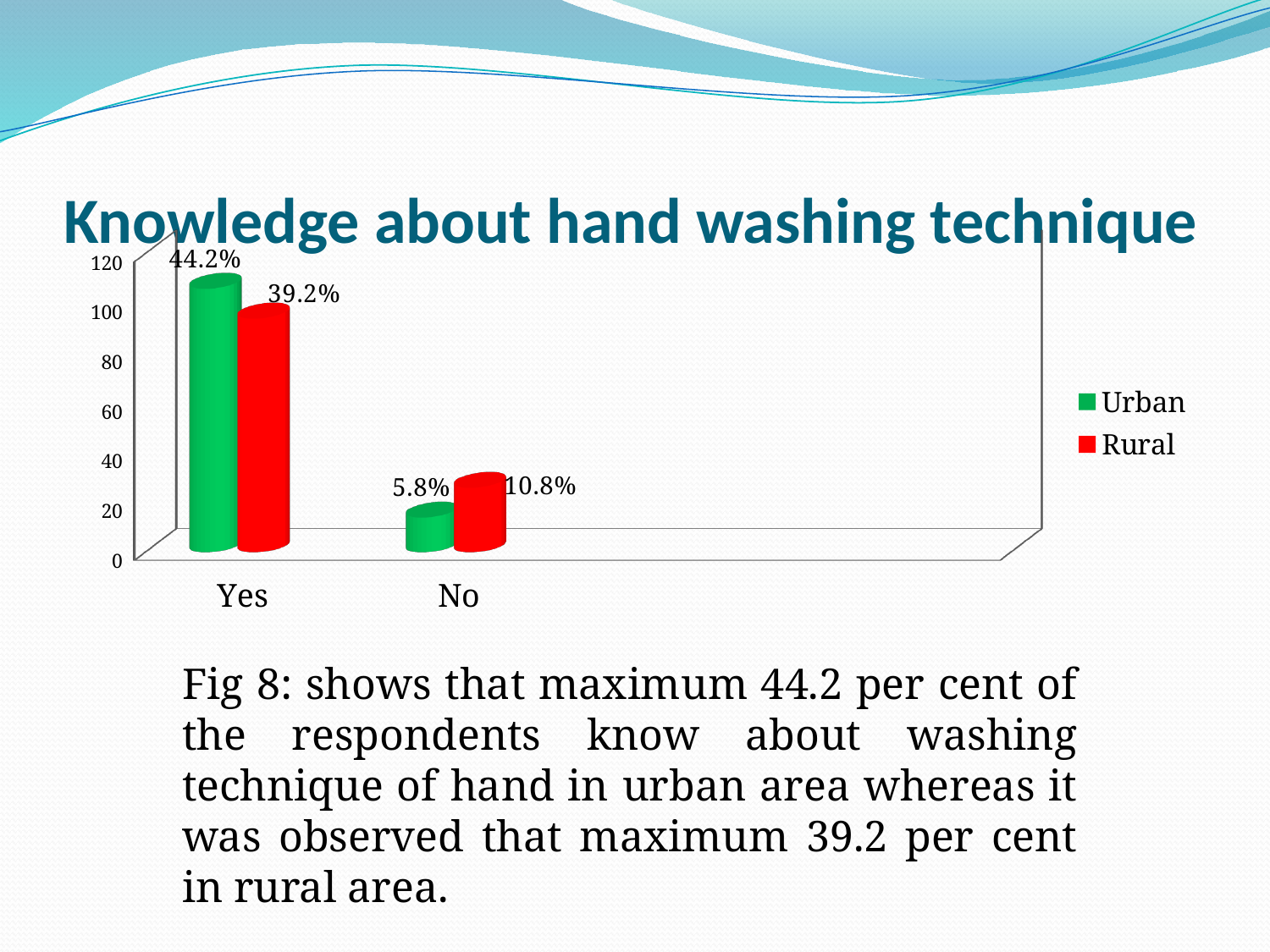
Which category has the lowest Rural value? No How many categories are shown on the x axis? 2 Which category has the highest Urban value? Yes What is the Rural value for the No category? 10.8% How many series does the legend list? 2 For the No category, which series has the larger value, Urban or Rural? Rural What is the Rural value for the Yes category? 39.2% What is the difference between the Urban and Rural values for the Yes category? 5.0% What type of chart is shown on the slide? Bar chart What is the Urban value for the No category? 5.8% What is the Urban value for the Yes category? 44.2% For the Yes category, which series has the larger value, Urban or Rural? Urban